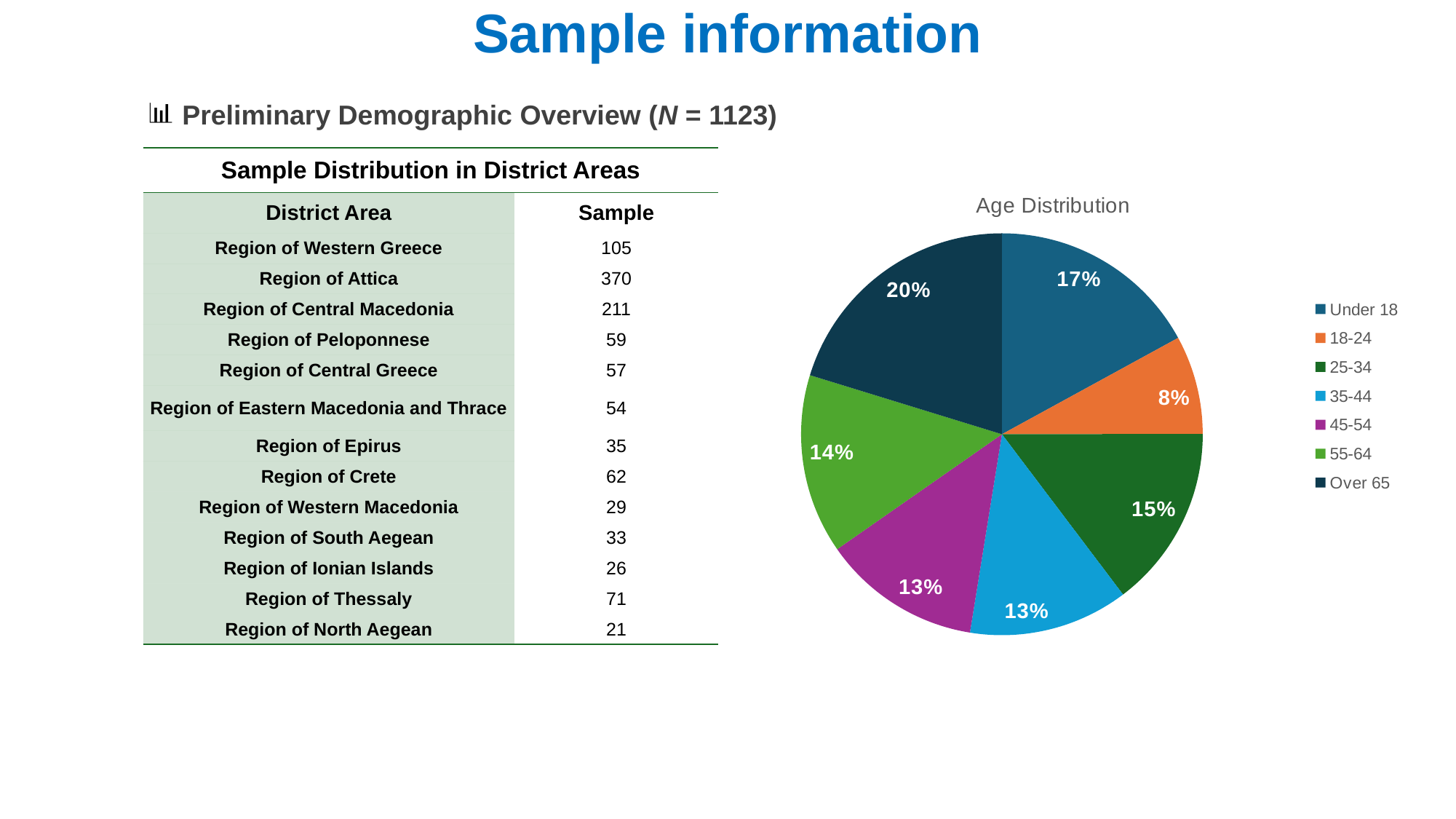
What type of chart is the Age Distribution chart? pie chart In the Age Distribution pie chart, what share is the 18-24 slice? 8% In the Age Distribution pie chart, what share is the 25-34 slice? 15% In the Age Distribution pie chart, what share is the 55-64 slice? 14% In the Age Distribution pie chart, which age group has the largest share? Over 65 In the Age Distribution pie chart, which age group has the smallest share? 18-24 In the Age Distribution pie chart, which slice is larger: Under 18 or 25-34? Under 18 How many age groups does the legend of the Age Distribution pie chart list? 7 In the Age Distribution pie chart, what is the difference in percentage points between the Over 65 slice and the 18-24 slice? 12 What is the title of the pie chart on the slide? Age Distribution